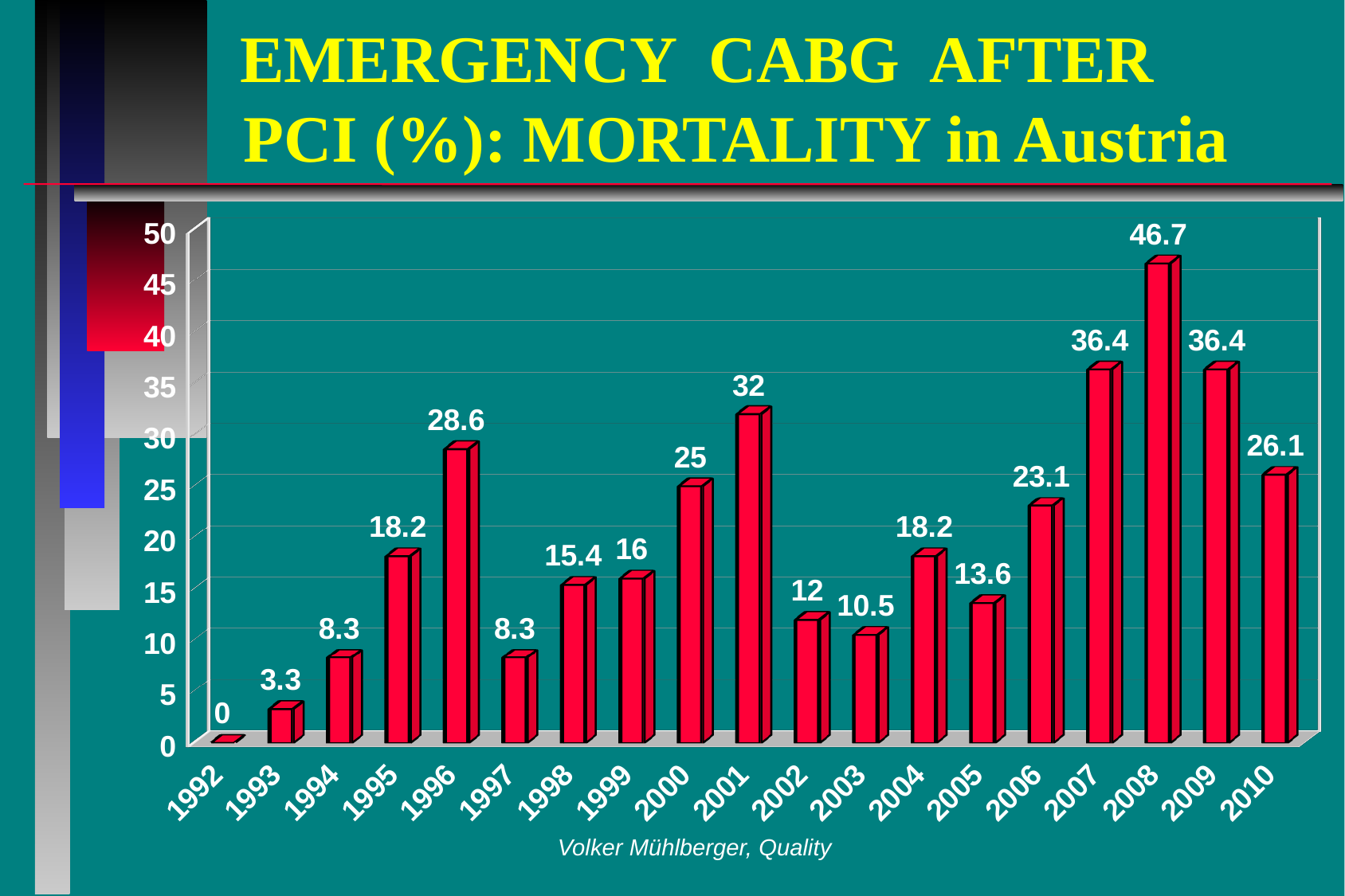
What is the value for 2008? 46.7 Which year has the lowest value? 1992 What kind of chart is this? bar chart How many years are shown on the x axis? 19 What is the difference between the values for 2008 and 2010? 20.6 Which is larger, the value for 2001 or the value for 2006? 2001 What is the title of the chart? EMERGENCY CABG AFTER PCI (%): MORTALITY in Austria What is the value for 2003? 10.5 Do the values rise or fall from 2005 to 2008? rise Which year has the highest value? 2008 Is the value for 2007 greater or less than 30? greater What is the value for 1996? 28.6